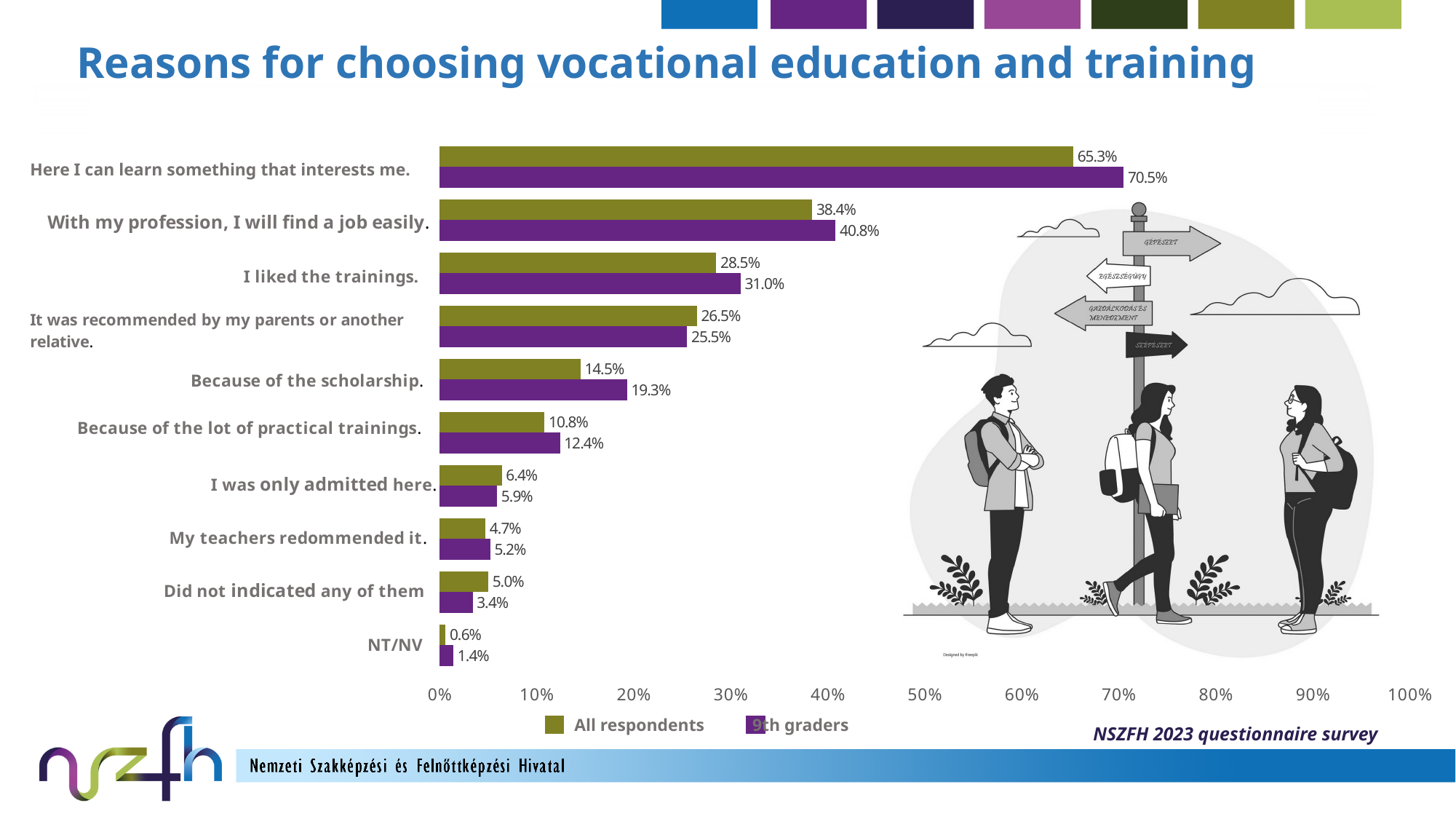
Which reason has the lowest value for all respondents? NT/NV What is the source noted at the bottom right of the chart? NSZFH 2023 questionnaire survey For "It was recommended by my parents or another relative", which is larger: all respondents or 9th graders? All respondents What percentage of 9th graders chose "With my profession, I will find a job easily"? 40.8% Which reason has the highest value for 9th graders? Here I can learn something that interests me. What percentage of 9th graders chose "Because of the scholarship"? 19.3% What is the difference between 9th graders and all respondents for "Here I can learn something that interests me"? 5.2% What percentage of all respondents chose "Here I can learn something that interests me"? 65.3% How many reasons (categories) are shown in the chart? 10 What kind of chart is shown on the slide? Bar chart Is the value for all respondents for "I liked the trainings" greater or less than 30%? less How many series does the legend list? 2